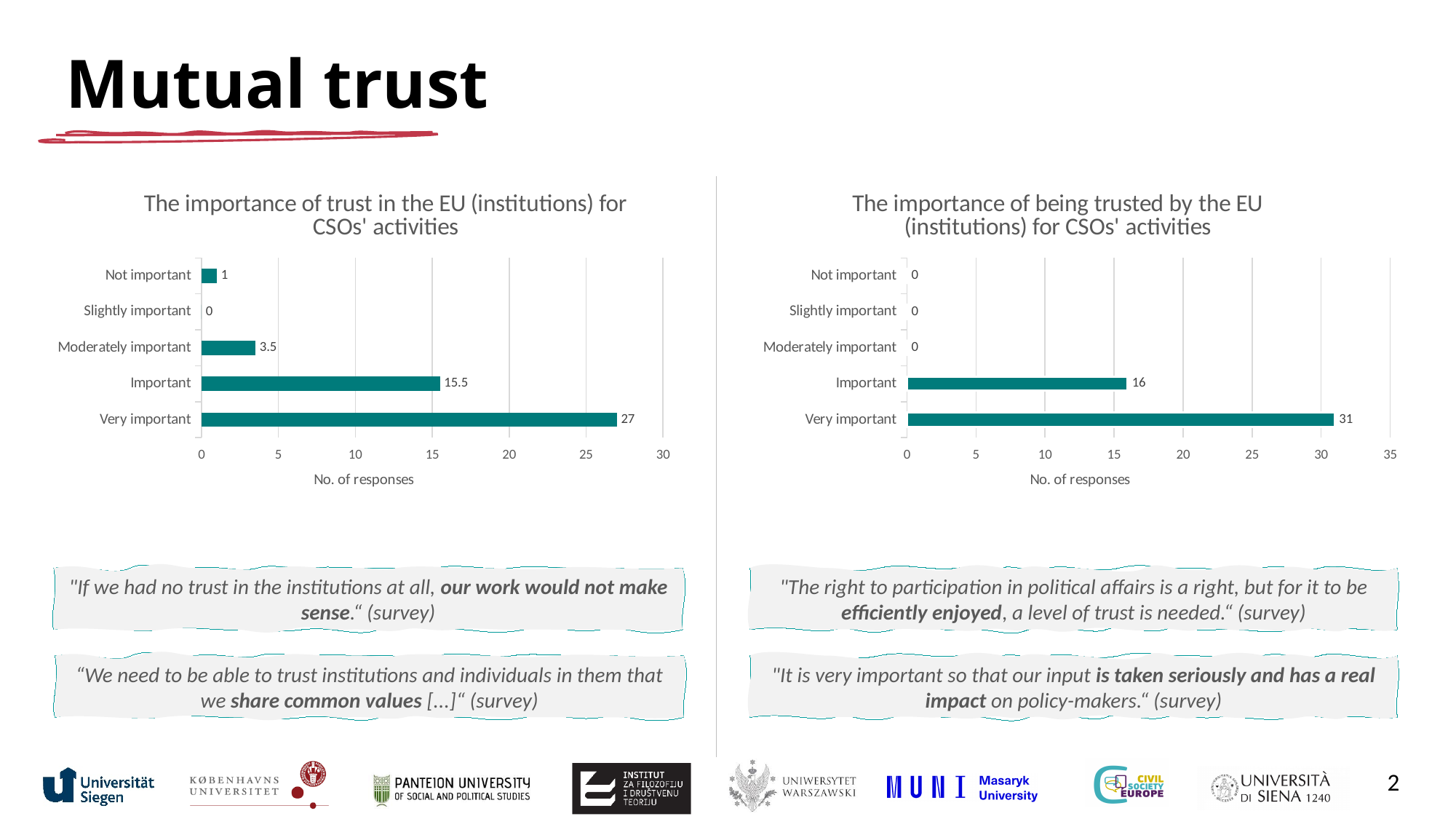
In the left chart, 'The importance of trust in the EU (institutions) for CSOs' activities', what is the value for 'Very important'? 27 In the left chart, 'The importance of trust in the EU (institutions) for CSOs' activities', what is the difference between 'Very important' and 'Important'? 11.5 How many categories are shown in the left chart, 'The importance of trust in the EU (institutions) for CSOs' activities'? 5 What kind of chart is the right chart, 'The importance of being trusted by the EU (institutions) for CSOs' activities'? Bar chart Which is larger: 'Very important' in the left chart or 'Very important' in the right chart? Very important in the right chart In the right chart, 'The importance of being trusted by the EU (institutions) for CSOs' activities', what is the difference between 'Very important' and 'Important'? 15 In the left chart, 'The importance of trust in the EU (institutions) for CSOs' activities', which category has the lowest value? Slightly important What is the x-axis label of the left chart, 'The importance of trust in the EU (institutions) for CSOs' activities'? No. of responses In the left chart, 'The importance of trust in the EU (institutions) for CSOs' activities', what is the value for 'Moderately important'? 3.5 In the right chart, 'The importance of being trusted by the EU (institutions) for CSOs' activities', is the value for 'Very important' greater or less than 30? greater In the right chart, 'The importance of being trusted by the EU (institutions) for CSOs' activities', what is the value for 'Important'? 16 In the right chart, 'The importance of being trusted by the EU (institutions) for CSOs' activities', which category has the highest value? Very important